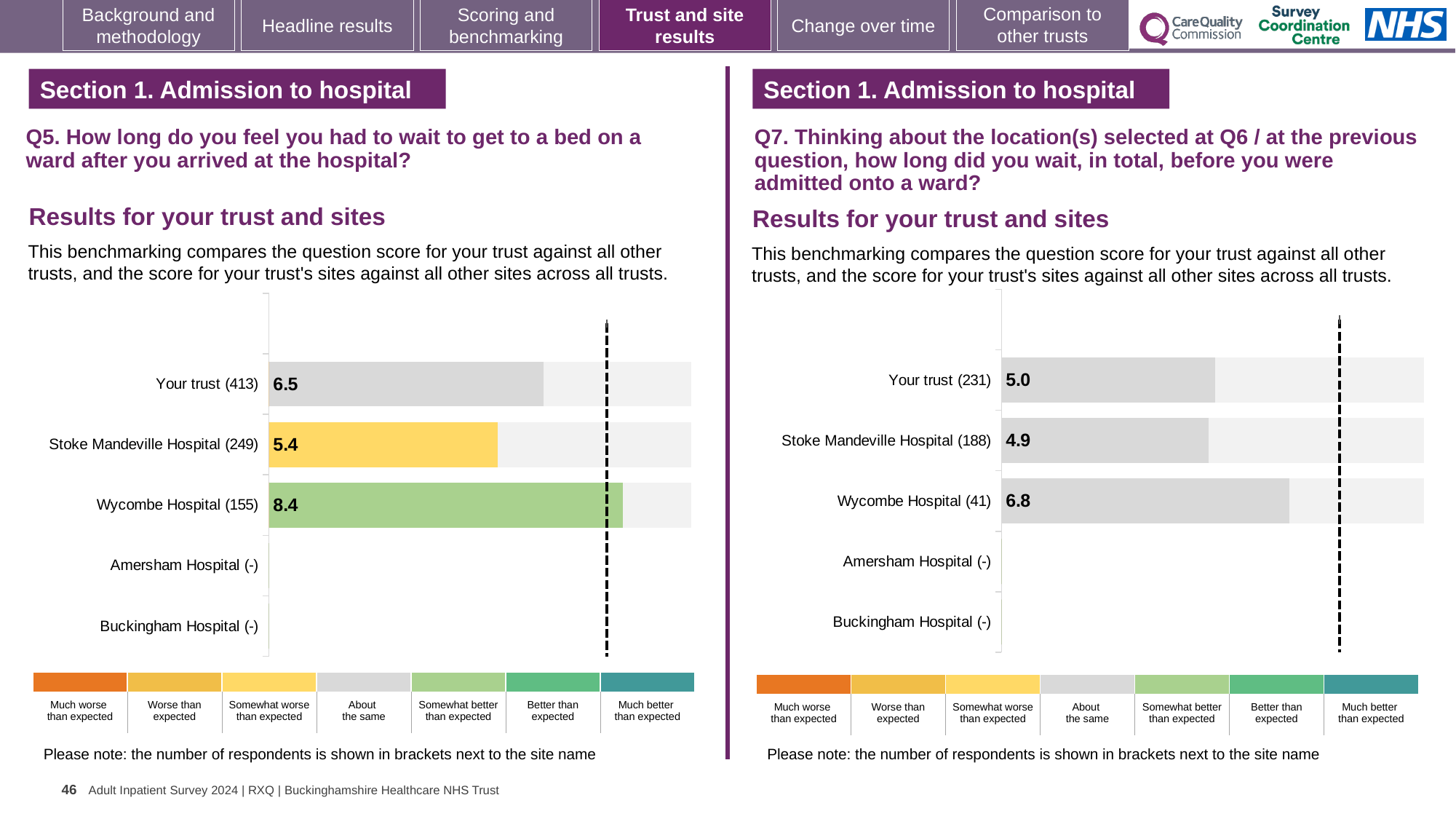
On the Q5 chart (left), what is the score for Stoke Mandeville Hospital? 5.4 On the Q7 chart (right), what is the difference between the scores for Wycombe Hospital and Your trust? 1.8 On the Q5 chart (left), what is the difference between the scores for Wycombe Hospital and Stoke Mandeville Hospital? 3.0 On the Q5 chart (left), which site has the highest score? Wycombe Hospital On the Q7 chart (right), what is the score for Your trust? 5.0 On the Q7 chart (right), how many respondents are shown for Stoke Mandeville Hospital? 188 On the Q7 chart (right), which is larger: the score for Wycombe Hospital or Your trust? Wycombe Hospital On the Q7 chart (right), what is the score for Wycombe Hospital? 6.8 On the Q5 chart (left), what is the score for Your trust? 6.5 On the Q5 chart (left), what colour is the bar for Wycombe Hospital? Green What type of chart is used on the Q5 chart (left)? Bar chart On the Q7 chart (right), which site has the lowest score? Stoke Mandeville Hospital